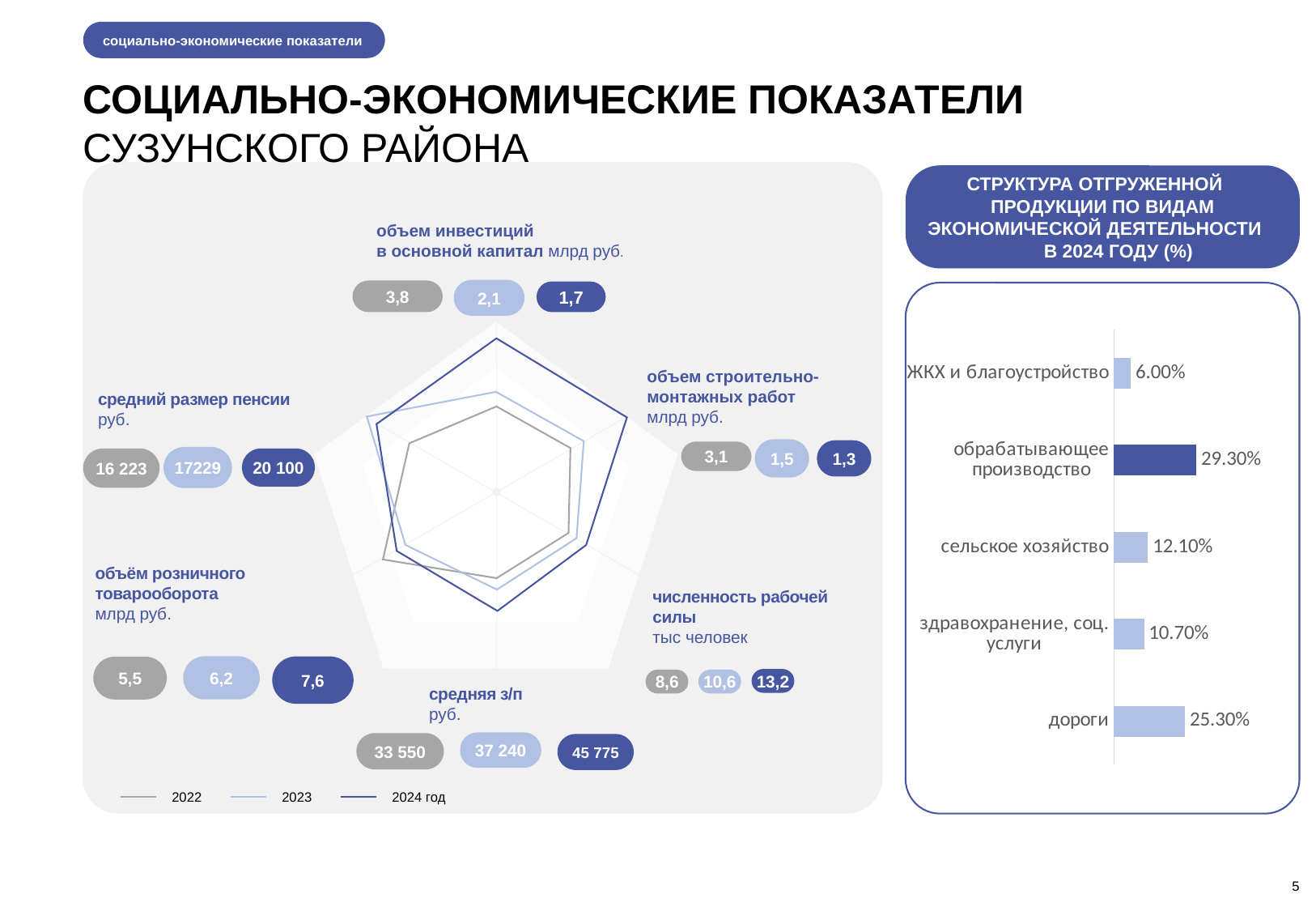
In the bar chart on the right, which category has the highest value? обрабатывающее производство In the radar chart on the left, what is the value for объем инвестиций в основной капитал in 2022? 3,8 What kind of chart is shown on the right side of the slide? bar chart In the bar chart on the right, how many categories are shown? 5 In the radar chart on the left, how many years does the legend list? 3 In the bar chart on the right, what is the difference between сельское хозяйство and здравоохранение, соц. услуги? 1.40% In the bar chart on the right, what is the value for дороги? 25.30% In the radar chart on the left, which is larger for численность рабочей силы: 2023 or 2024? 2024 What kind of chart is shown on the left side of the slide? radar chart In the bar chart on the right, what is the value for обрабатывающее производство? 29.30% In the bar chart on the right, which category has the lowest value? ЖКХ и благоустройство In the radar chart on the left, what is the value for средняя з/п in 2024? 45 775